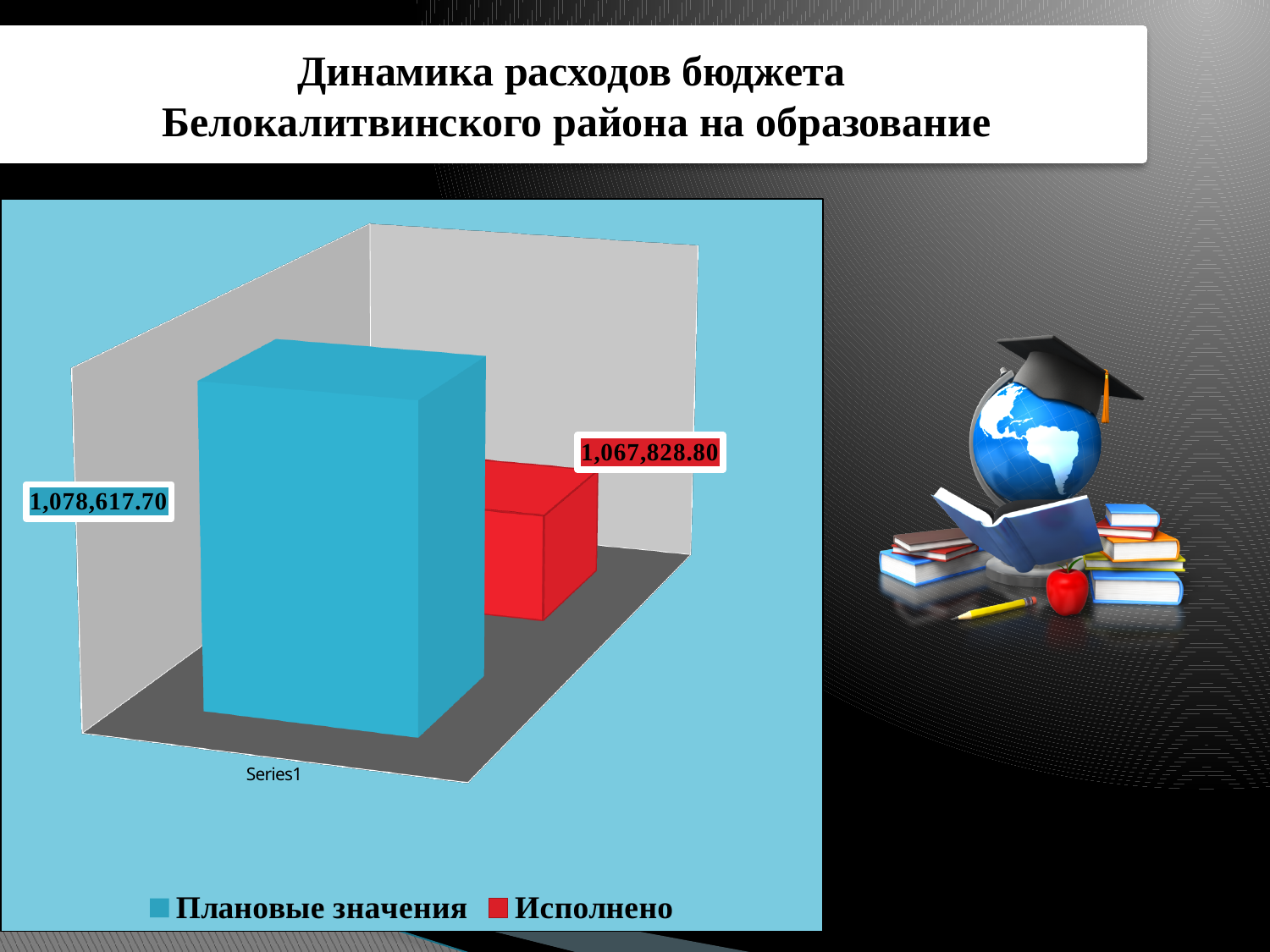
Which series has the highest value on the chart? Плановые значения What colour is the bar for "Исполнено"? Red How many bars are plotted on the chart? 2 What is the title of the slide containing the chart? Динамика расходов бюджета Белокалитвинского района на образование How many series does the legend list? 2 Which series has the lowest value on the chart? Исполнено What is the value shown for the series "Исполнено"? 1,067,828.80 What is the difference between the value for "Плановые значения" and the value for "Исполнено"? 10,788.90 Which series has the higher value, "Плановые значения" or "Исполнено"? Плановые значения What is the value shown for the series "Плановые значения"? 1,078,617.70 What kind of chart is shown on the slide? Bar chart